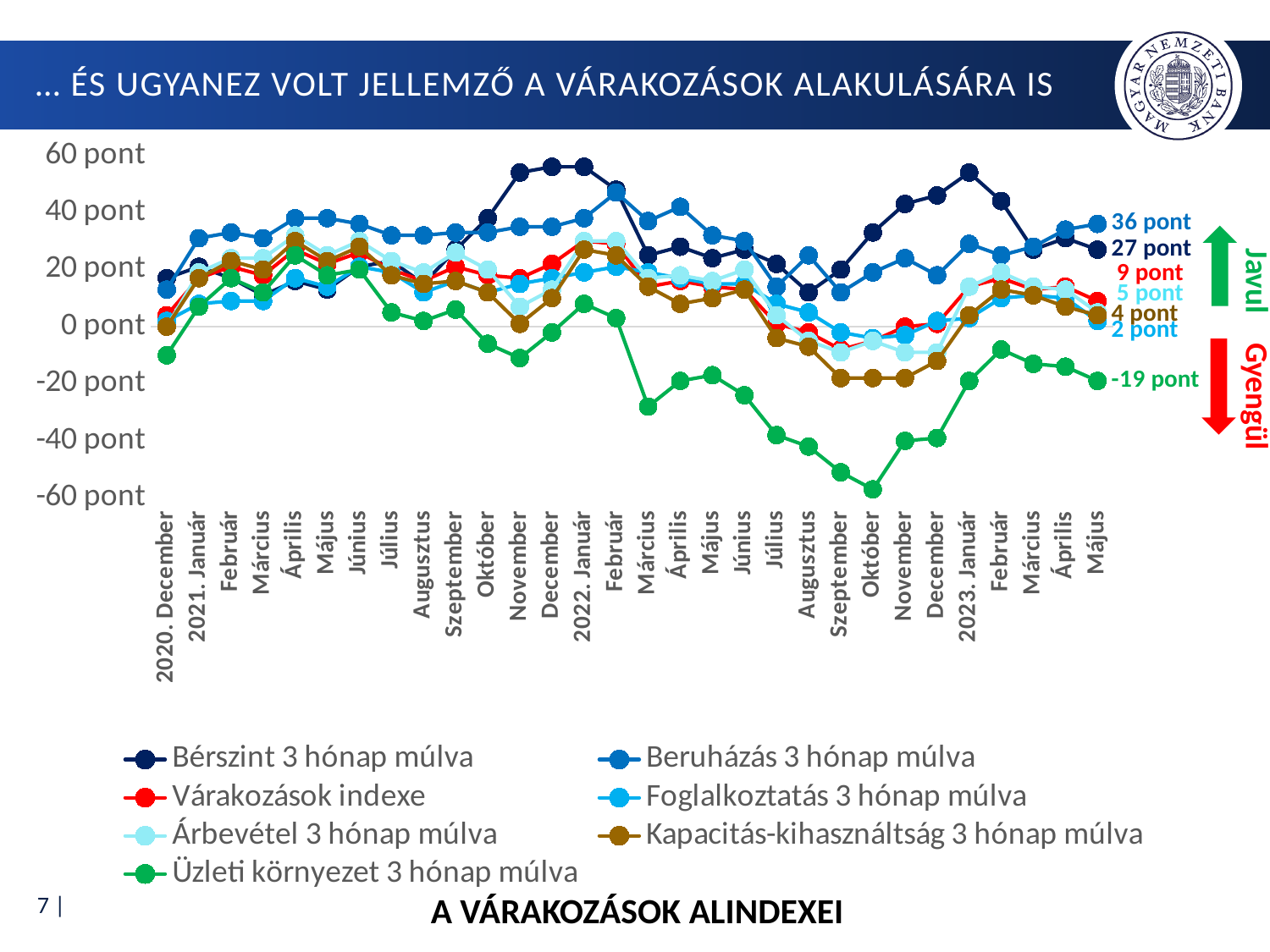
In Május 2023, which is larger: Bérszint 3 hónap múlva or Üzleti környezet 3 hónap múlva? Bérszint 3 hónap múlva Which series has the lowest value in Május 2023? Üzleti környezet 3 hónap múlva What is the value of Beruházás 3 hónap múlva in Május 2023? 36 pont Which series has the highest value in Május 2023? Beruházás 3 hónap múlva What is the value of Várakozások indexe in Május 2023? 9 pont What is the difference between Beruházás 3 hónap múlva and Bérszint 3 hónap múlva in Május 2023? 9 pont What is the title shown below the chart? A VÁRAKOZÁSOK ALINDEXEI What kind of chart is shown on the slide? line chart How many series does the legend list? 7 What is the value of Bérszint 3 hónap múlva in Május 2023? 27 pont Is the value for Üzleti környezet 3 hónap múlva in Október 2022 greater or less than -40 pont? less What is the value of Üzleti környezet 3 hónap múlva in Május 2023? -19 pont